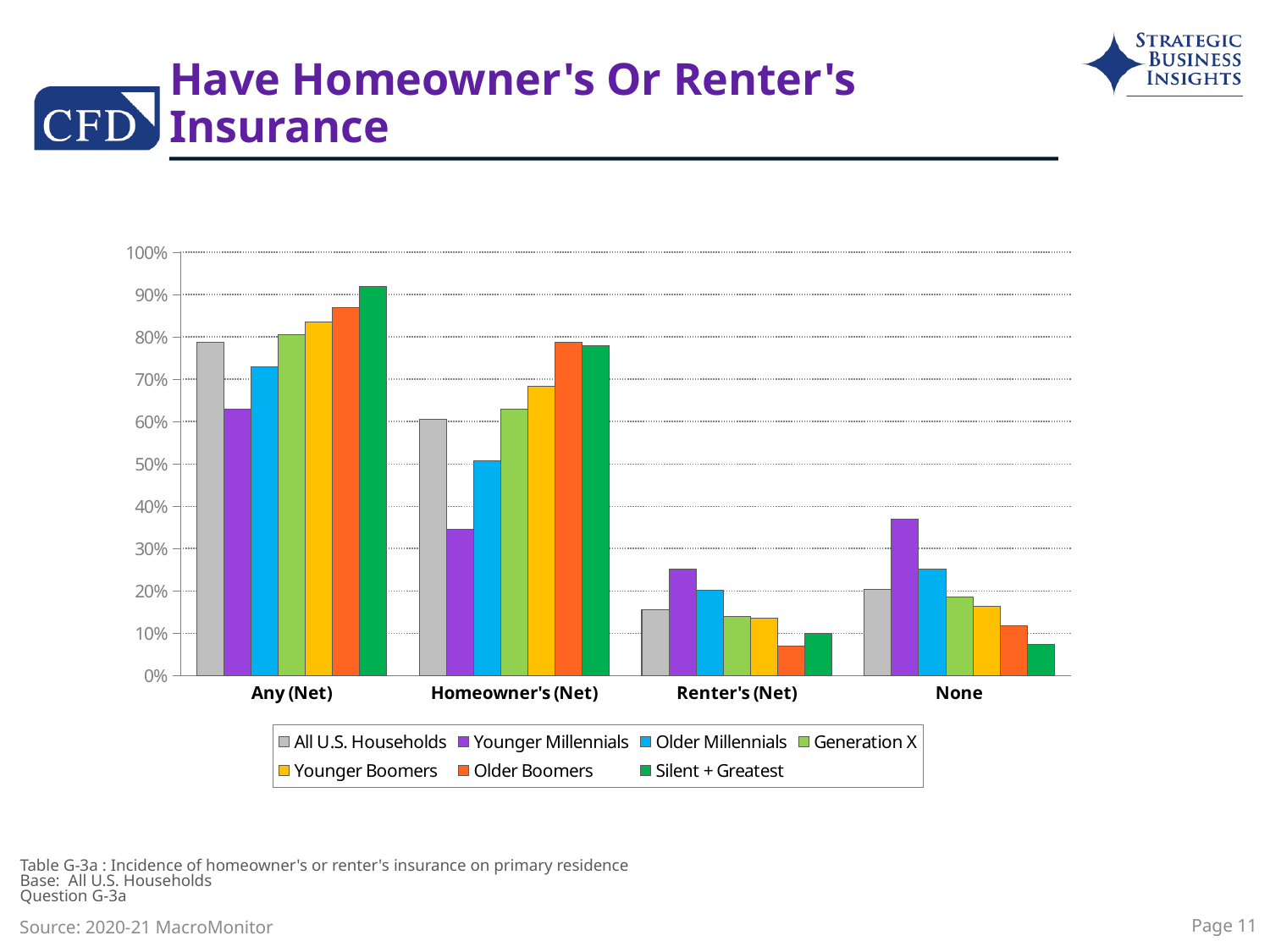
In the Any (Net) category, which series has the highest value? Silent + Greatest In the Any (Net) category, which series has the lowest value? Younger Millennials How many categories are shown along the x axis of the chart? 4 Is the value for Silent + Greatest in the Any (Net) category greater or less than 80%? greater In the None category, which series has the highest value? Younger Millennials In the Homeowner's (Net) category, which series has the lowest value? Younger Millennials In the Renter's (Net) category, which is larger: the value for Younger Millennials or the value for Older Millennials? Younger Millennials How many series does the chart's legend list? 7 Is the value for Younger Millennials in the Homeowner's (Net) category greater or less than 40%? less What is the title of the slide? Have Homeowner's Or Renter's Insurance In the Renter's (Net) category, which series has the lowest value? Older Boomers What kind of chart is shown on the slide? bar chart